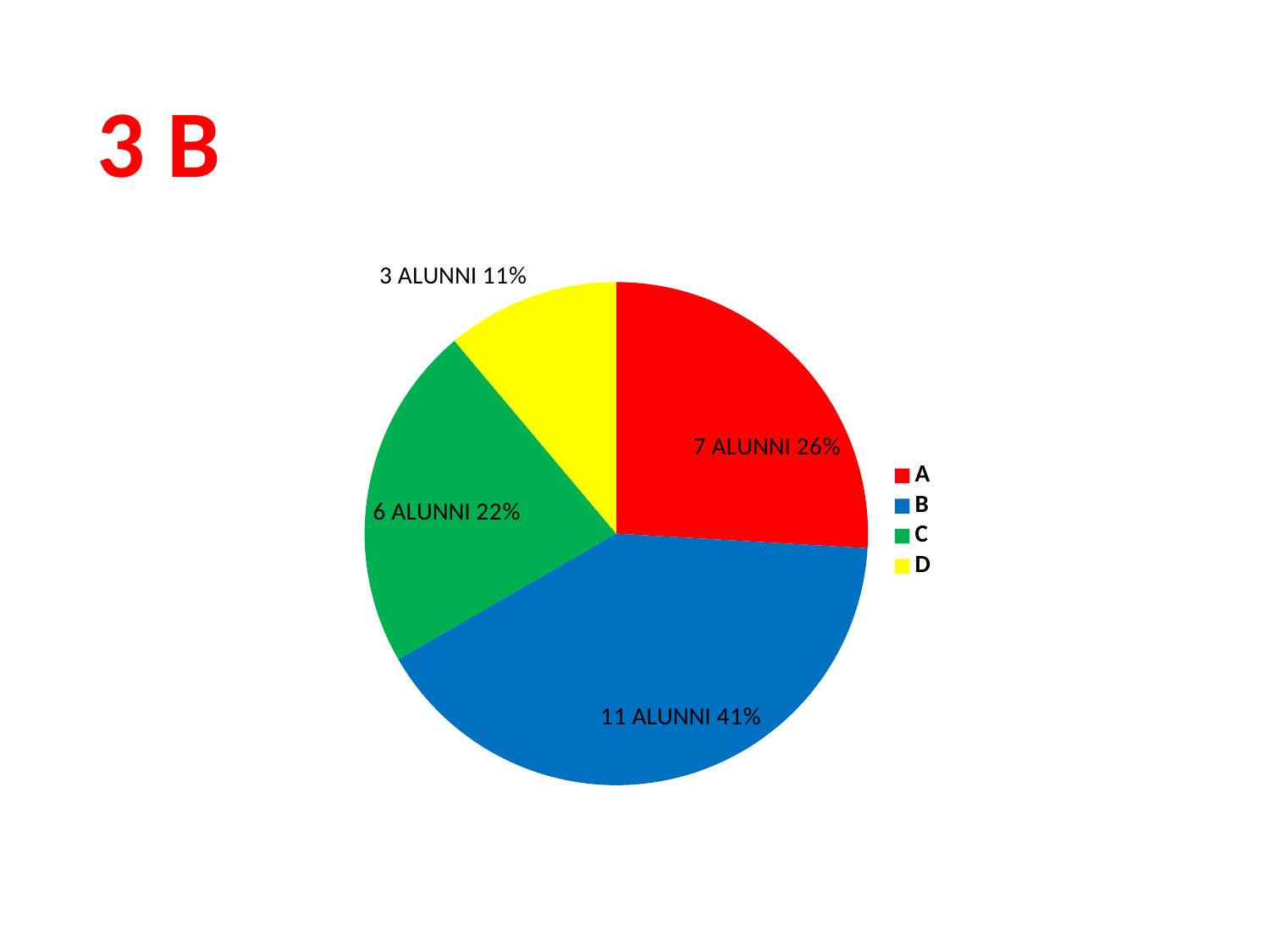
How many entries does the legend list? 4 What kind of chart is shown on the slide? pie chart How many slices does the pie chart have? 4 Which category has the smallest slice? D Which category has the largest slice? B How many alunni are in category C? 6 ALUNNI What share of the pie does category B represent? 41% What is the difference in number of alunni between category B and category A? 4 How many alunni are in category A? 7 ALUNNI What colour is the slice for category C? green What share of the pie does category D represent? 11% Which category has more alunni, A or C? A